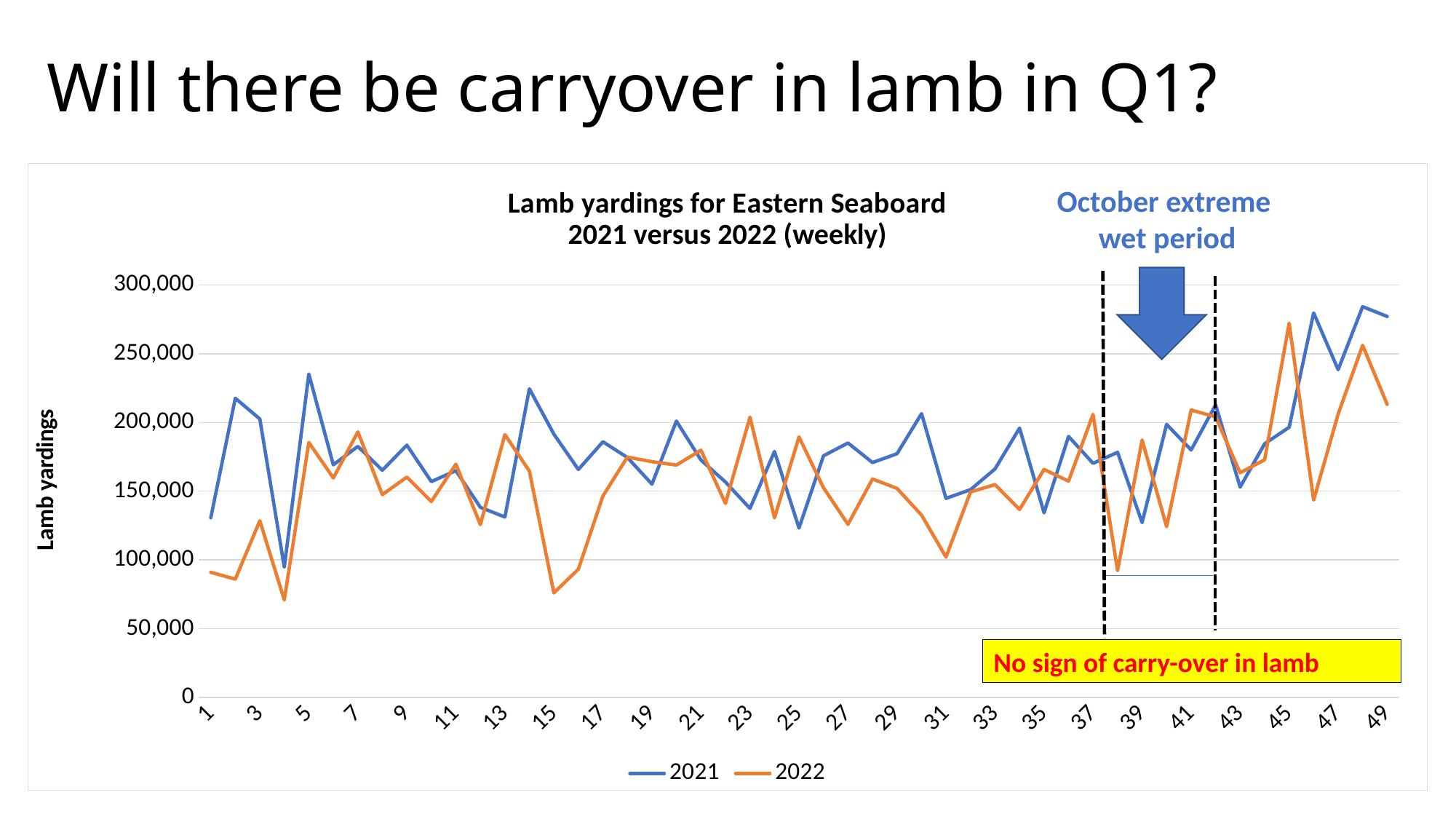
In which week does the 2021 series reach its lowest value? Week 4 Is the 2022 value for week 4 greater or less than 100,000? less Is the 2022 value for week 45 greater or less than 250,000? greater Is the 2021 value for week 5 greater or less than 200,000? greater What is the title of the chart? Lamb yardings for Eastern Seaboard 2021 versus 2022 (weekly) At week 15, which series has the larger value, 2021 or 2022? 2021 What kind of chart is shown on the slide? Line chart At week 45, which series has the larger value, 2021 or 2022? 2022 Which series is drawn in orange? 2022 How many series does the legend list? 2 What is the last week number labelled on the x axis? 49